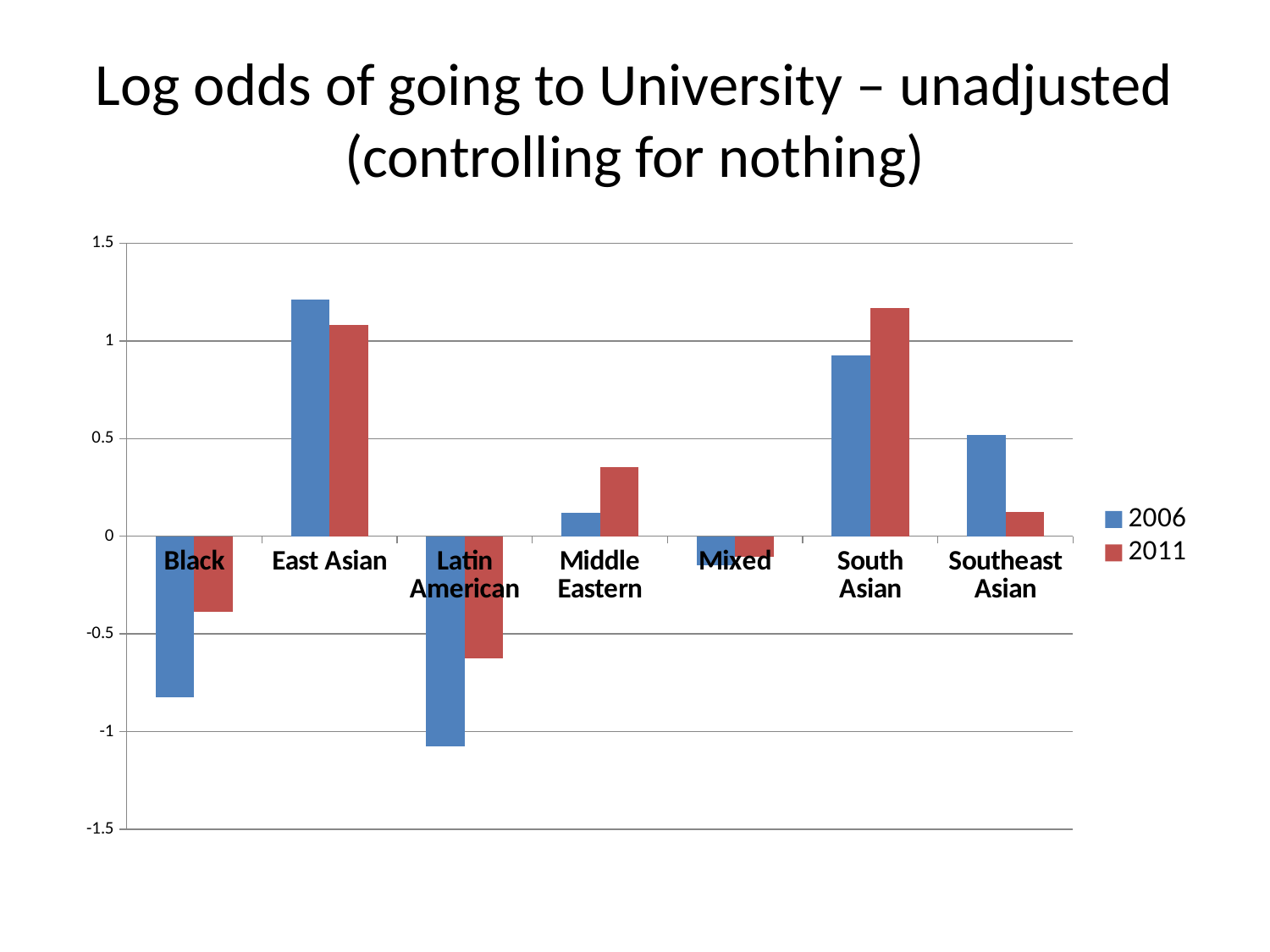
Is the 2006 value for Latin American greater or less than -1? less Which category has the highest 2006 value? East Asian For Southeast Asian, which is larger, the 2006 value or the 2011 value? 2006 How many series does the legend list? 2 Is the 2006 value for East Asian greater or less than 1? greater Which category has the lowest 2011 value? Latin American How many categories are shown on the x axis? 7 Which category has the highest 2011 value? South Asian Which category has the lowest 2006 value? Latin American What kind of chart is shown on the slide? bar chart Is the 2011 value for Black greater or less than -0.5? greater For Middle Eastern, which is larger, the 2006 value or the 2011 value? 2011